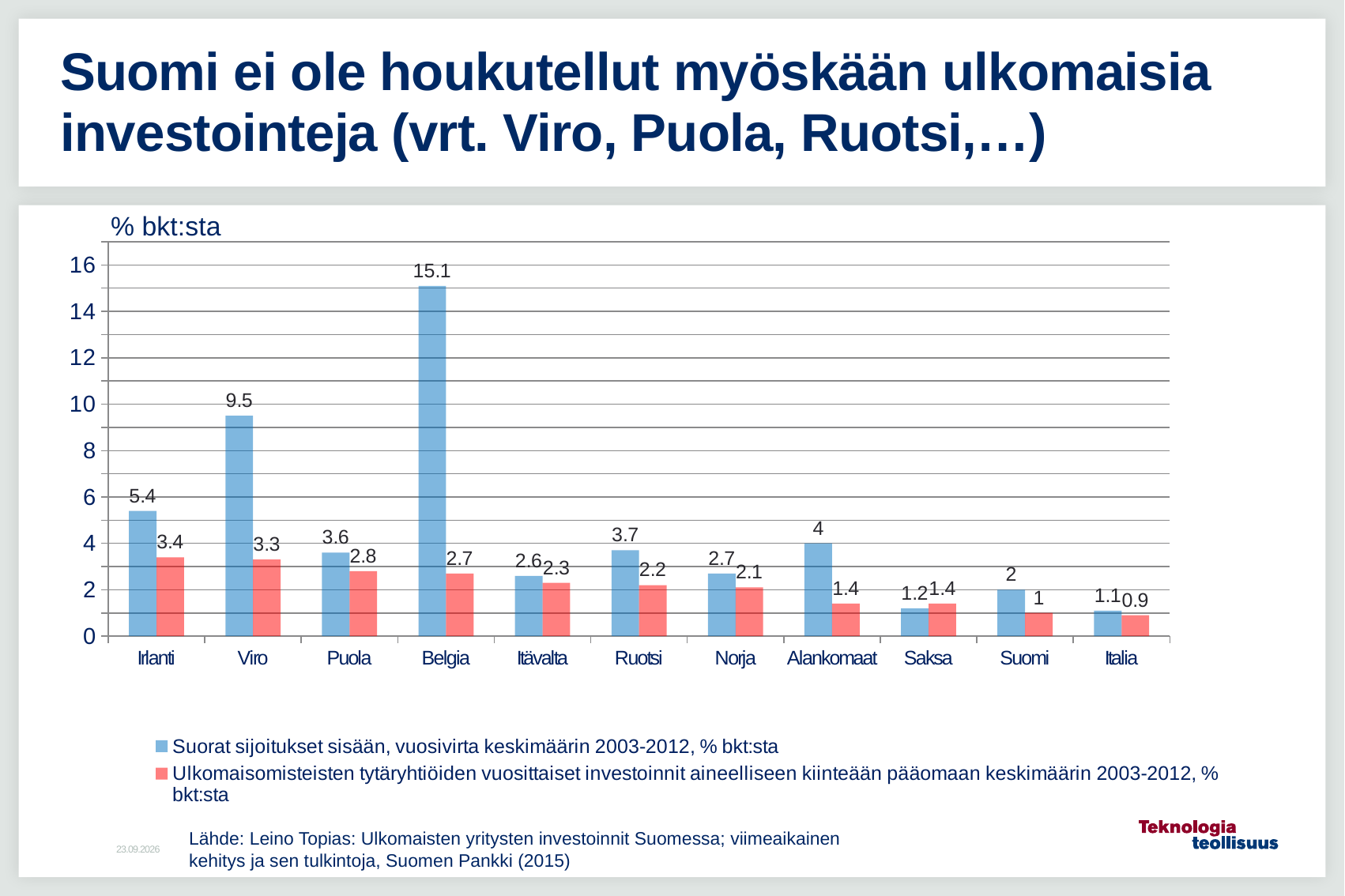
What is the value of 'Suorat sijoitukset sisään, vuosivirta keskimäärin 2003-2012, % bkt:sta' for Suomi? 2 How many countries are shown on the x axis of the chart? 11 What is the difference between the 'Suorat sijoitukset sisään' values for Viro and Suomi? 7.5 What unit label is shown above the y axis of the chart? % bkt:sta What kind of chart is shown on the slide? Bar chart Which country has the lowest value for 'Ulkomaisomisteisten tytäryhtiöiden vuosittaiset investoinnit aineelliseen kiinteään pääomaan keskimäärin 2003-2012, % bkt:sta'? Italia What is the value of 'Suorat sijoitukset sisään, vuosivirta keskimäärin 2003-2012, % bkt:sta' for Belgia? 15.1 What is the value of 'Ulkomaisomisteisten tytäryhtiöiden vuosittaiset investoinnit aineelliseen kiinteään pääomaan keskimäärin 2003-2012, % bkt:sta' for Viro? 3.3 Which is larger for Saksa: the 'Suorat sijoitukset sisään' value or the 'Ulkomaisomisteisten tytäryhtiöiden vuosittaiset investoinnit' value? Ulkomaisomisteisten tytäryhtiöiden vuosittaiset investoinnit Which country has the highest value for 'Suorat sijoitukset sisään, vuosivirta keskimäärin 2003-2012, % bkt:sta'? Belgia Is the 'Suorat sijoitukset sisään' value for Viro greater or less than 8? greater How many series does the chart's legend list? 2